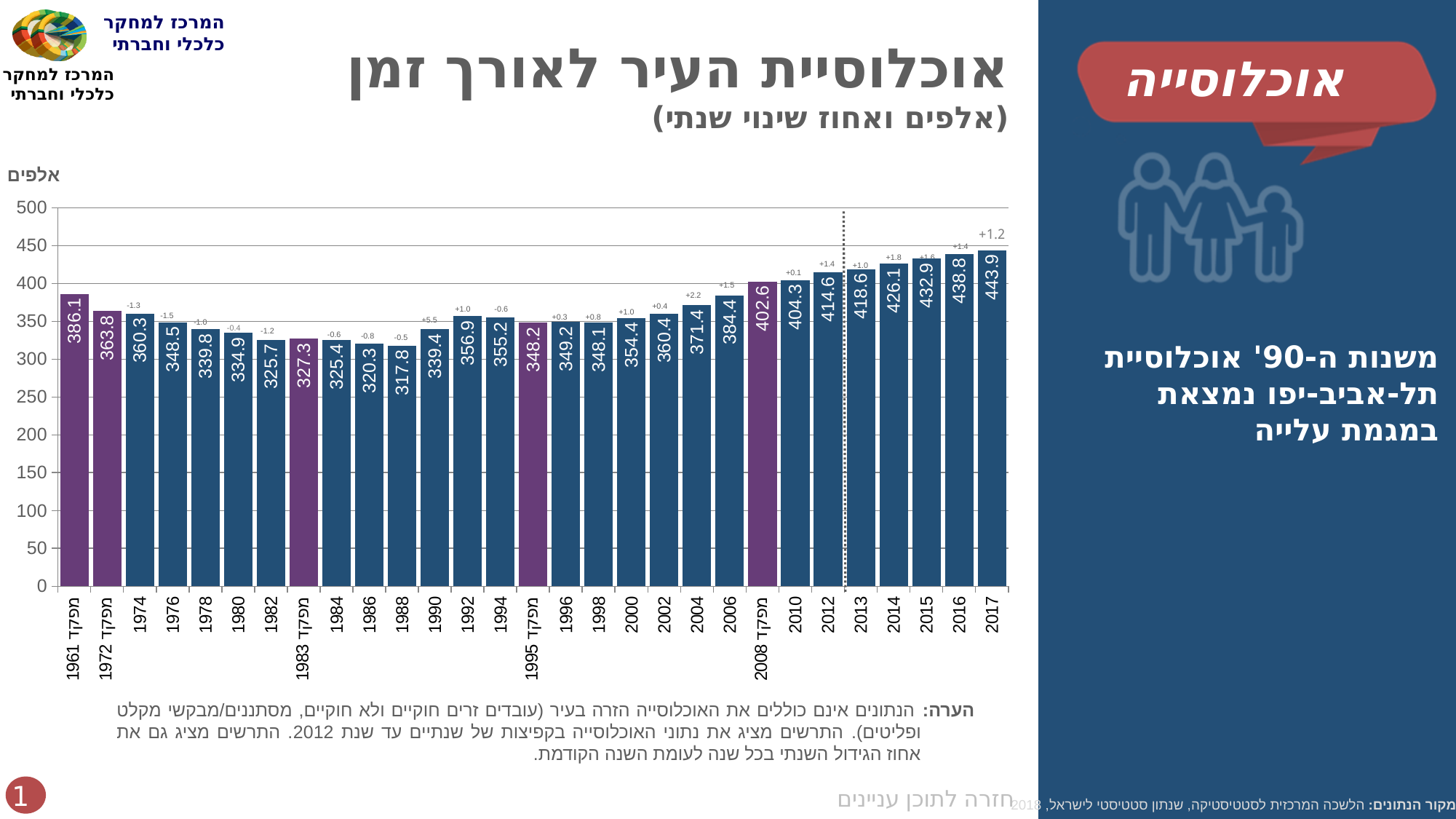
How many bars (years) are plotted on the chart? 29 Which year has the lowest population value on the chart? 1988 What was the city's population (in thousands) in 2017? 443.9 What was the city's population (in thousands) in 1988? 317.8 What is the difference in population (in thousands) between the 2008 census and 2006? 18.2 What is the difference in population (in thousands) between 2017 and the 1961 census? 57.8 Which is larger, the population in 1974 or in 1994? 1974 What type of chart is shown on the slide? bar chart Which year has the highest population value on the chart? 2017 Is the population value for 2012 greater or less than 400? greater What annual percentage change is printed above the 2017 bar? +1.2 What was the city's population (in thousands) in the 1961 census (מפקד 1961)? 386.1